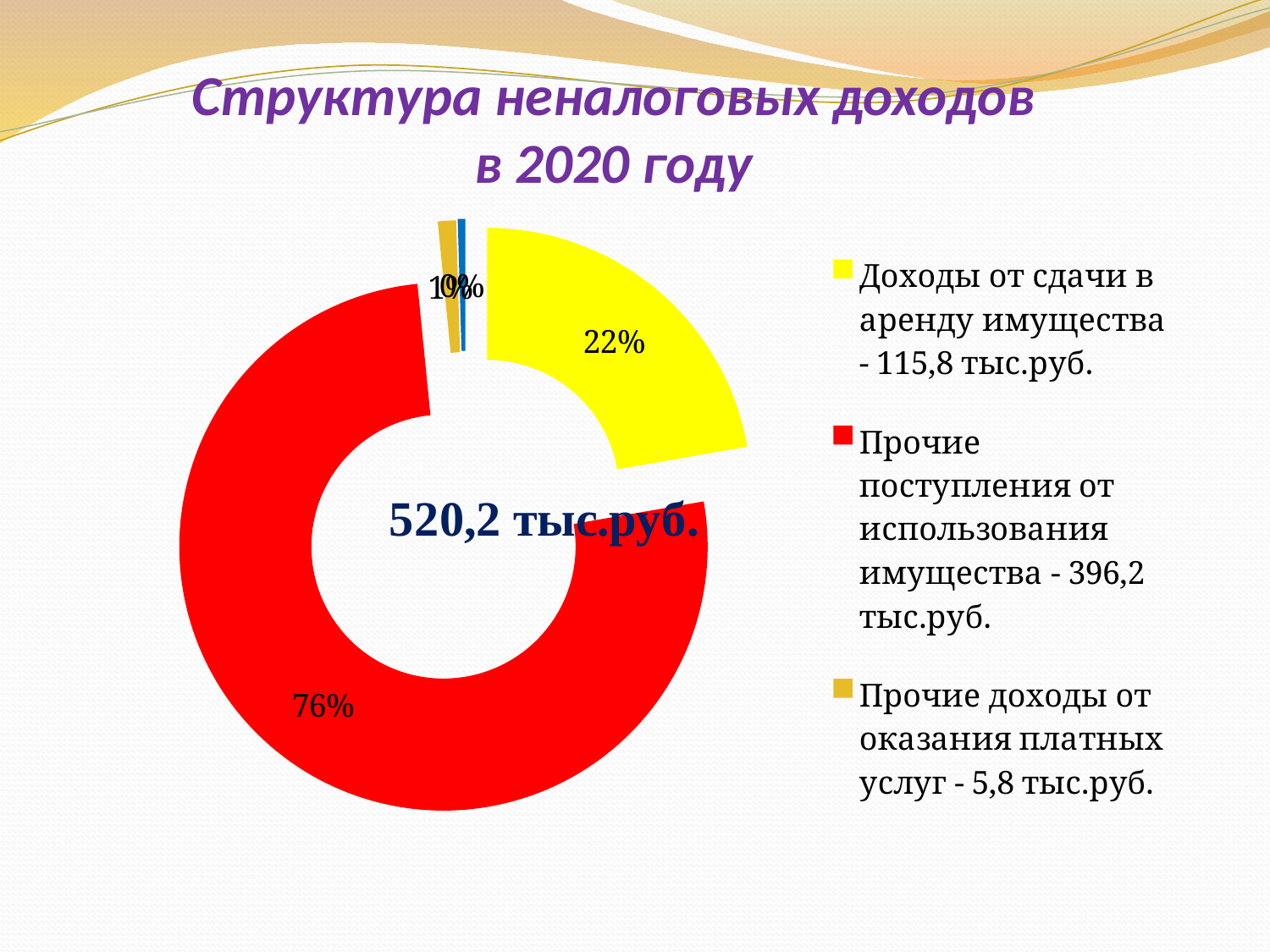
Which category has the largest slice of the pie? Прочие поступления от использования имущества What value does the legend give for "Прочие поступления от использования имущества"? 396,2 тыс.руб. How many categories does the legend list? 3 By how many percentage points does the 76% slice exceed the 22% slice? 54 percentage points What total amount is printed in the centre of the doughnut chart? 520,2 тыс.руб. What value does the legend give for "Доходы от сдачи в аренду имущества"? 115,8 тыс.руб. What value does the legend give for "Прочие доходы от оказания платных услуг"? 5,8 тыс.руб. What kind of chart is shown on the slide? pie chart (doughnut) What share of the pie does the slice for "Прочие поступления от использования имущества" (red) represent? 76% What share of the pie does the slice for "Доходы от сдачи в аренду имущества" (yellow) represent? 22% Which is larger: the share for "Прочие поступления от использования имущества" or the share for "Доходы от сдачи в аренду имущества"? Прочие поступления от использования имущества Which of the three legend categories has the smallest value? Прочие доходы от оказания платных услуг